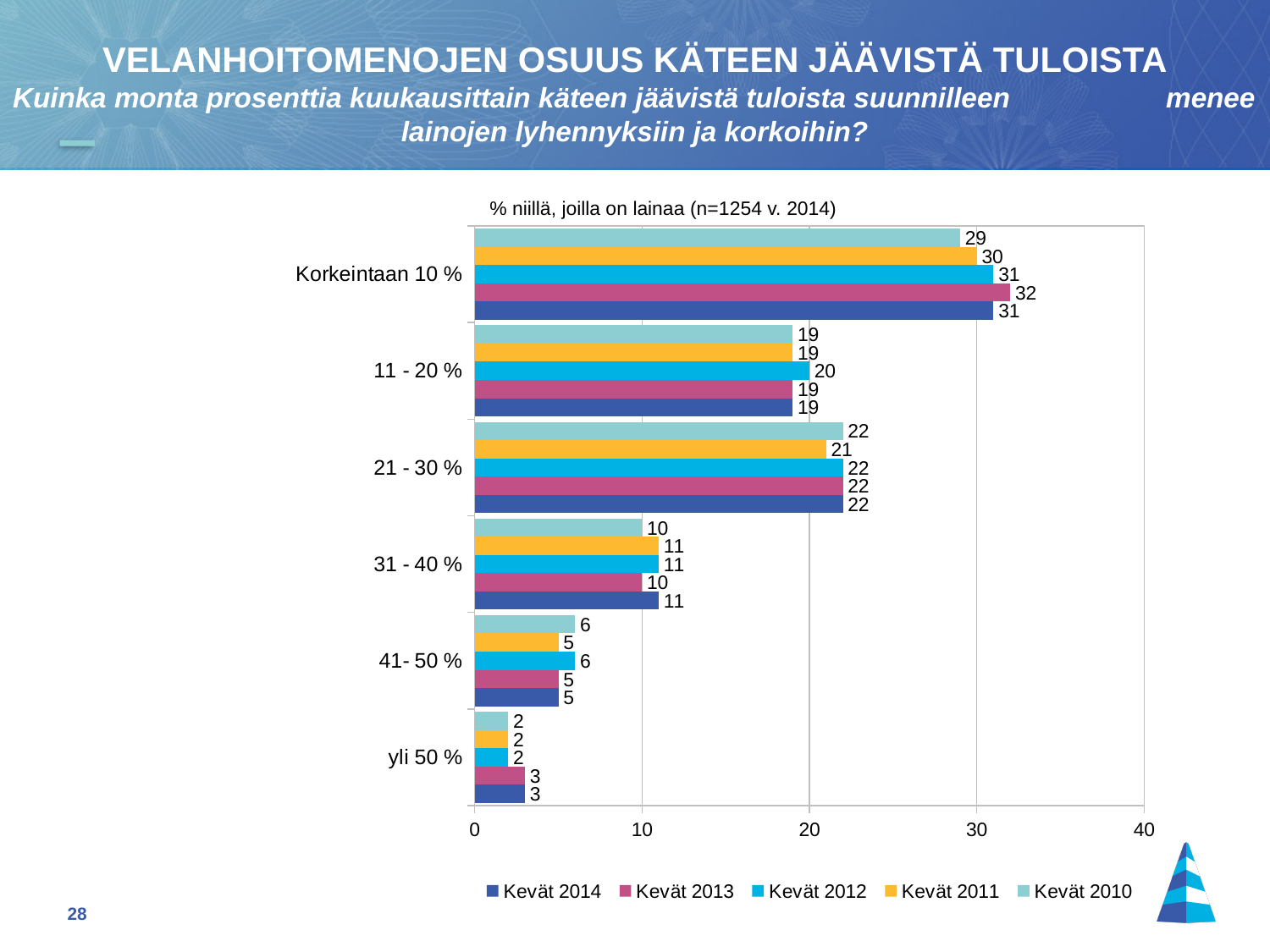
What is the value for Kevät 2011 in the "21 - 30 %" category? 21 What kind of chart is shown on the slide? Bar chart How many categories are shown on the y axis of the chart? 6 What is the difference between the Kevät 2013 and Kevät 2010 values in the "Korkeintaan 10 %" category? 3 What is the value for Kevät 2013 in the "Korkeintaan 10 %" category? 32 Which category has the highest value for Kevät 2014? Korkeintaan 10 % How many series does the legend list? 5 What is the value for Kevät 2010 in the "31 - 40 %" category? 10 Which category has the lowest value for Kevät 2010? yli 50 % What is the value for Kevät 2012 in the "11 - 20 %" category? 20 What is the value for Kevät 2014 in the "Korkeintaan 10 %" category? 31 Which is larger in the "41- 50 %" category: the value for Kevät 2012 or for Kevät 2011? Kevät 2012